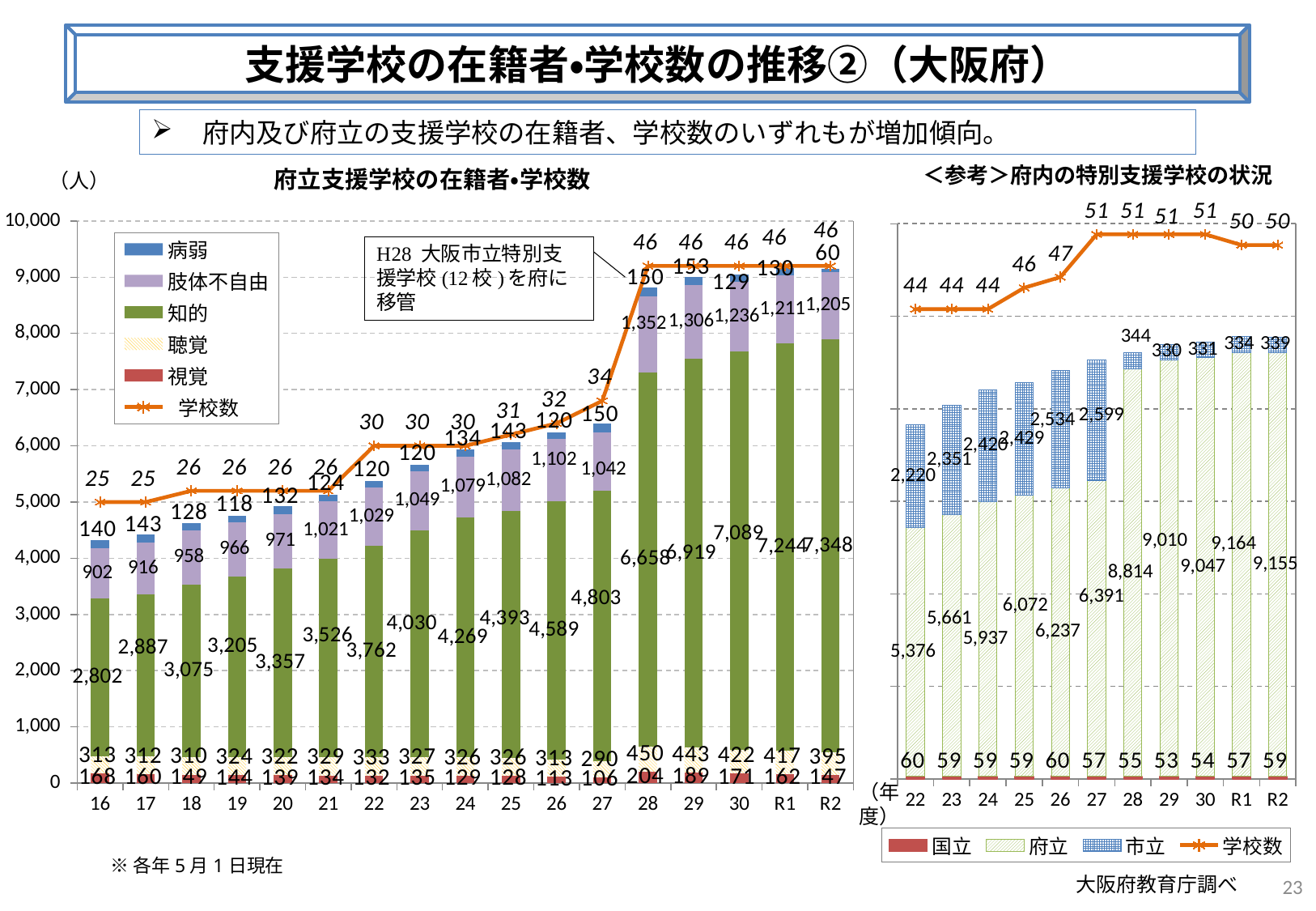
In the left chart (府立支援学校の在籍者・学校数), what is the 学校数 value for year 28? 46 In the right chart (＜参考＞府内の特別支援学校の状況), what is the highest value of the 学校数 line? 51 In the left chart (府立支援学校の在籍者・学校数), does the 知的 value rise or fall from year 16 to R2? rise In the right chart (＜参考＞府内の特別支援学校の状況), what is the difference between the 府立 value for R2 and for year 22? 3,779 In the left chart (府立支援学校の在籍者・学校数), by how much did 学校数 increase from year 27 to year 28? 12 How many year categories are shown on the x axis of the left chart (府立支援学校の在籍者・学校数)? 17 How many series does the legend of the left chart (府立支援学校の在籍者・学校数) list? 6 In the left chart (府立支援学校の在籍者・学校数), what is the value of 肢体不自由 for year 28? 1,352 How many year categories are shown on the x axis of the right chart (＜参考＞府内の特別支援学校の状況)? 11 In the left chart (府立支援学校の在籍者・学校数), what is the total of the stacked bar for R2? 9,155 In the left chart (府立支援学校の在籍者・学校数), what is the value of 知的 for R2? 7,348 In the right chart (＜参考＞府内の特別支援学校の状況), what is the value of 市立 for year 27? 2,599